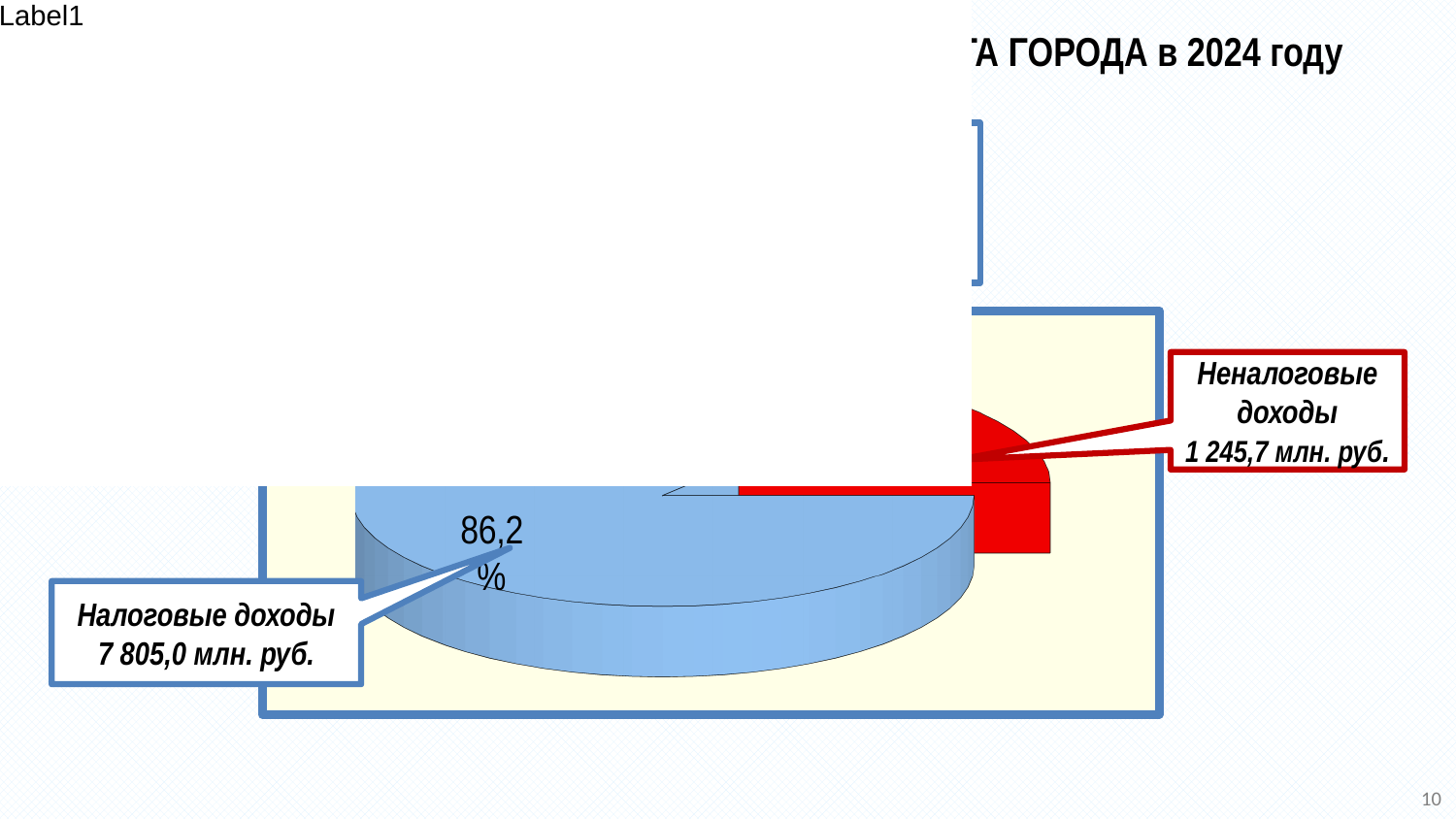
What colour is the Неналоговые доходы slice? red How many slices does the pie chart have? 2 What is the difference between Налоговые доходы and Неналоговые доходы? 6 559,3 млн. руб. What colour is the Налоговые доходы slice? blue Which category has the larger value, Налоговые доходы or Неналоговые доходы? Налоговые доходы What is the value shown for Налоговые доходы? 7 805,0 млн. руб. What kind of chart is shown on the slide? pie chart What is the value shown for Неналоговые доходы? 1 245,7 млн. руб. Which slice of the pie is the smallest? Неналоговые доходы What share of the pie does the Налоговые доходы slice represent? 86,2 % What is the combined total of Налоговые доходы and Неналоговые доходы? 9 050,7 млн. руб. Which slice of the pie is the largest? Налоговые доходы